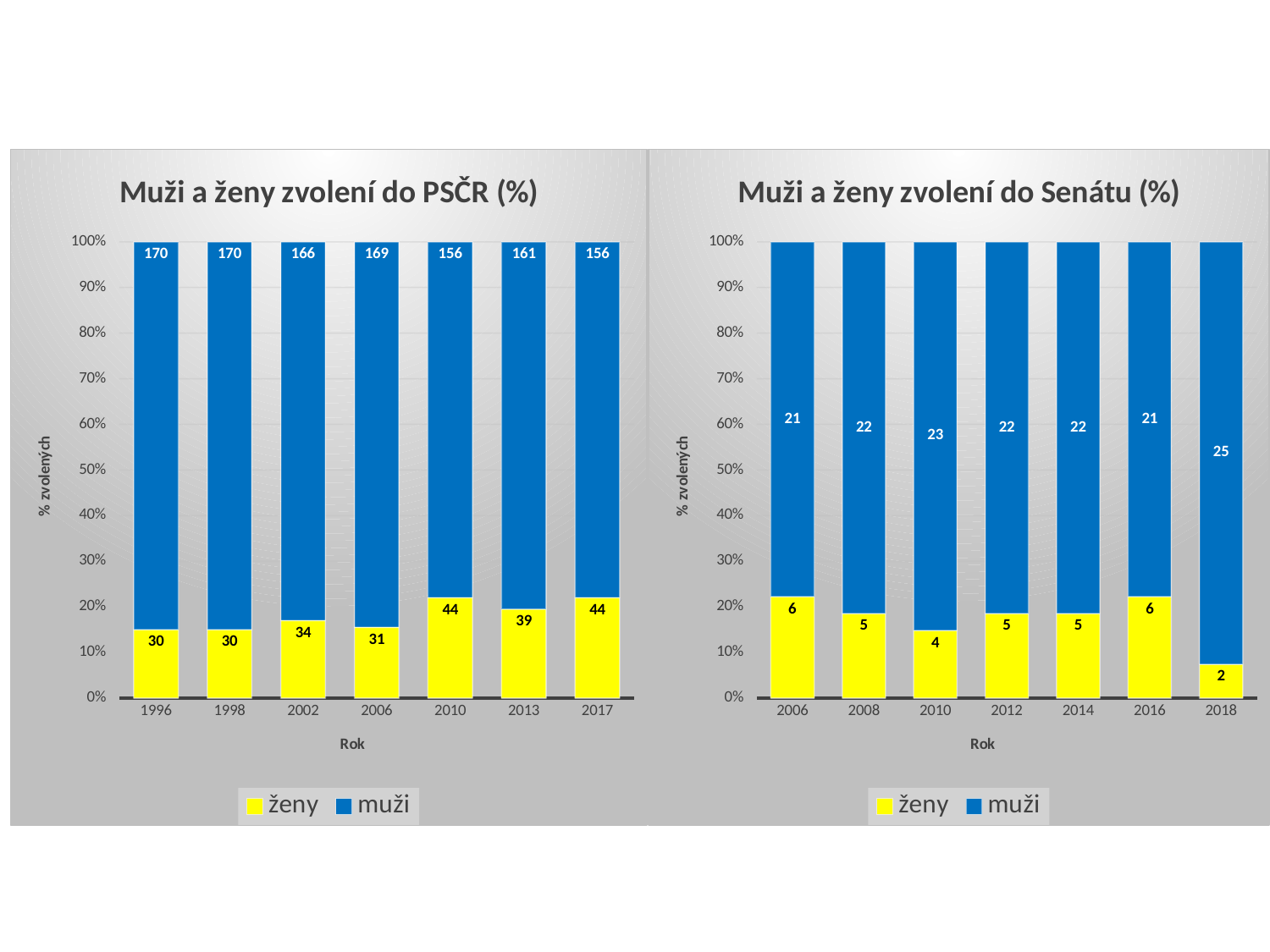
In the chart 'Muži a ženy zvolení do Senátu (%)', is the ženy label for 2010 larger or smaller than the ženy label for 2016? smaller In the chart 'Muži a ženy zvolení do Senátu (%)', which year has the highest data label for muži? 2018 In the chart 'Muži a ženy zvolení do PSČR (%)', which year has the lowest data label for muži? 2010 and 2017 (156) In the chart 'Muži a ženy zvolení do Senátu (%)', what is the data label for ženy in 2018? 2 How many series does the legend of the chart 'Muži a ženy zvolení do PSČR (%)' list? 2 In the chart 'Muži a ženy zvolení do PSČR (%)', what is the difference between the ženy labels for 2017 and 1996? 14 In the chart 'Muži a ženy zvolení do PSČR (%)', what is the data label for ženy in 2010? 44 What type of chart is 'Muži a ženy zvolení do Senátu (%)'? stacked bar chart In the chart 'Muži a ženy zvolení do PSČR (%)', what is the total of the ženy and muži labels for 2013? 200 In the chart 'Muži a ženy zvolení do Senátu (%)', is the ženy share of the 2018 bar greater or less than 10%? less How many years are shown on the x axis of the chart 'Muži a ženy zvolení do Senátu (%)'? 7 In the chart 'Muži a ženy zvolení do PSČR (%)', what is the data label for muži in 2002? 166